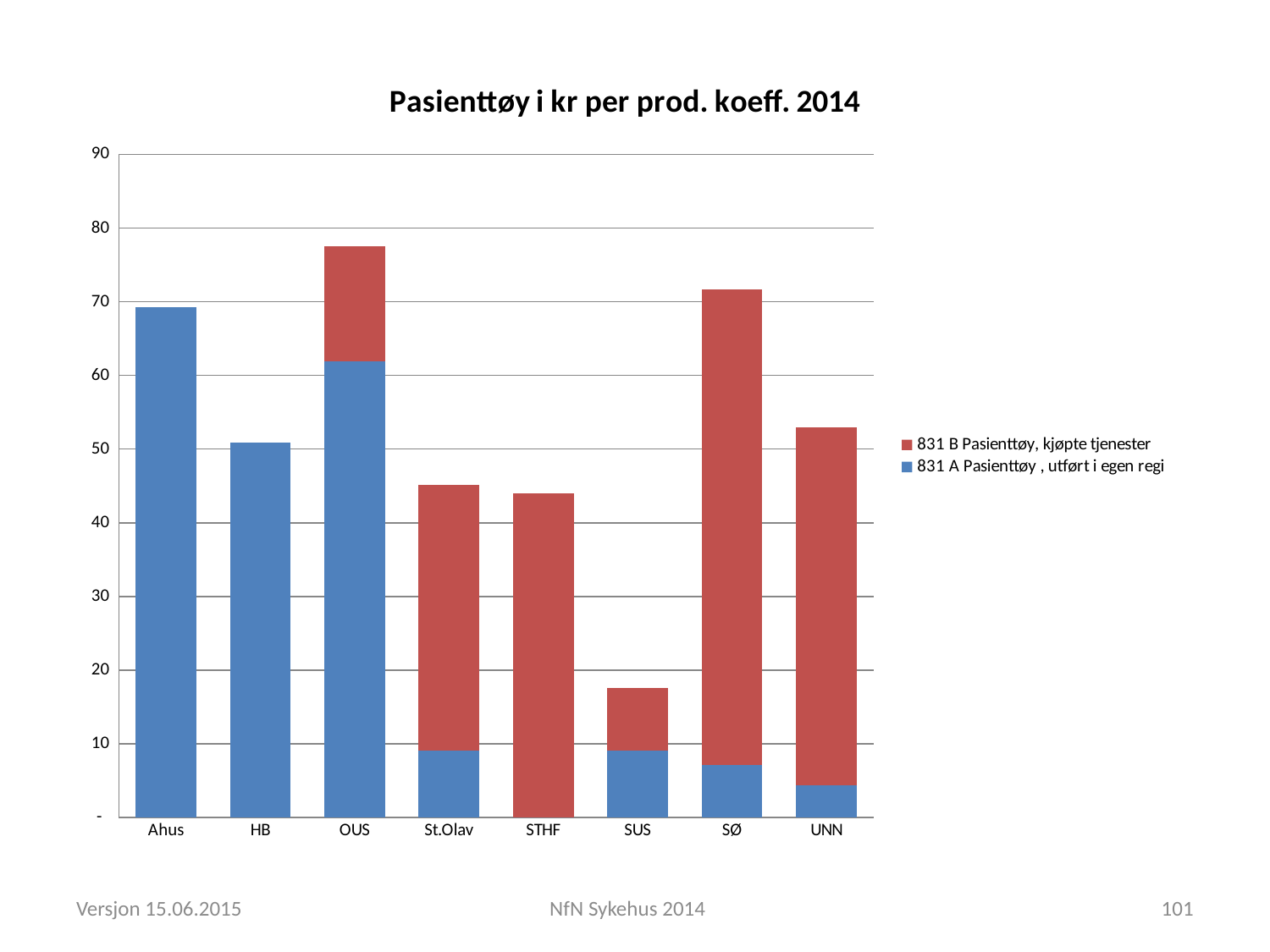
Which hospital has the lowest total bar? SUS Which has the larger total bar, Ahus or HB? Ahus Is the total value for Ahus greater or less than 60? greater Is the total value for STHF greater or less than 50? less What kind of chart is shown on the slide? stacked bar chart How many series does the legend list? 2 Is the total value for SUS greater or less than 20? less Which has the larger total bar, SØ or UNN? SØ Which series is shown in red in the legend? 831 B Pasienttøy, kjøpte tjenester How many hospitals (categories) are shown on the x axis? 8 What is the title of the chart? Pasienttøy i kr per prod. koeff. 2014 Which hospital has the highest total bar? OUS